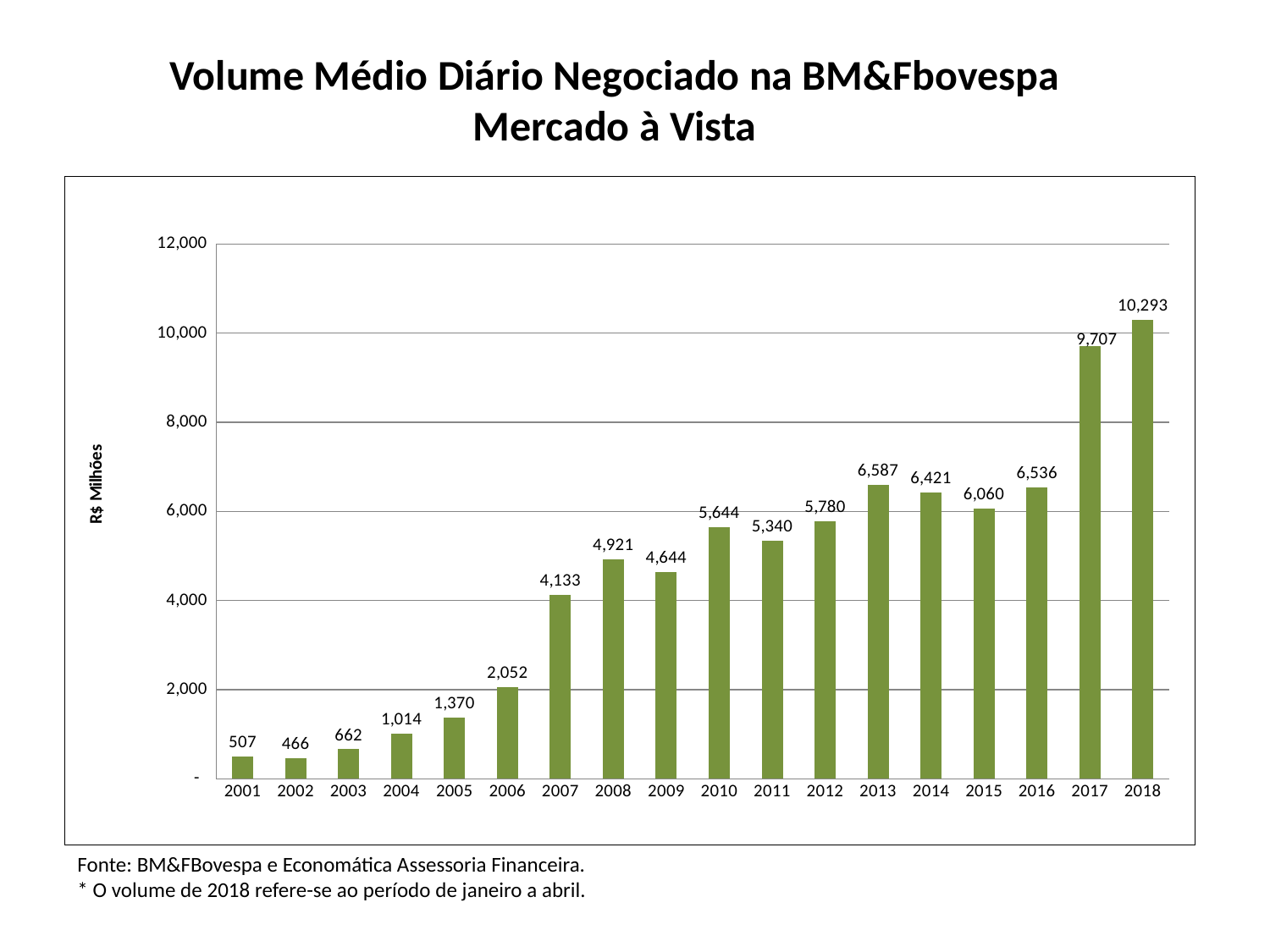
Which year has the highest value? 2018 Which year has the lowest value? 2002 What is the value for 2013? 6,587 What is the difference between the values for 2018 and 2017? 586 Do the values generally rise or fall from 2001 to 2018? rise Is the value for 2010 greater or less than 6,000? less What kind of chart is this? bar chart How many years are shown on the x axis? 18 What is the label on the vertical axis? R$ Milhões What is the value for 2007? 4,133 What is the value for 2001? 507 Which is larger, the value for 2014 or the value for 2016? 2016